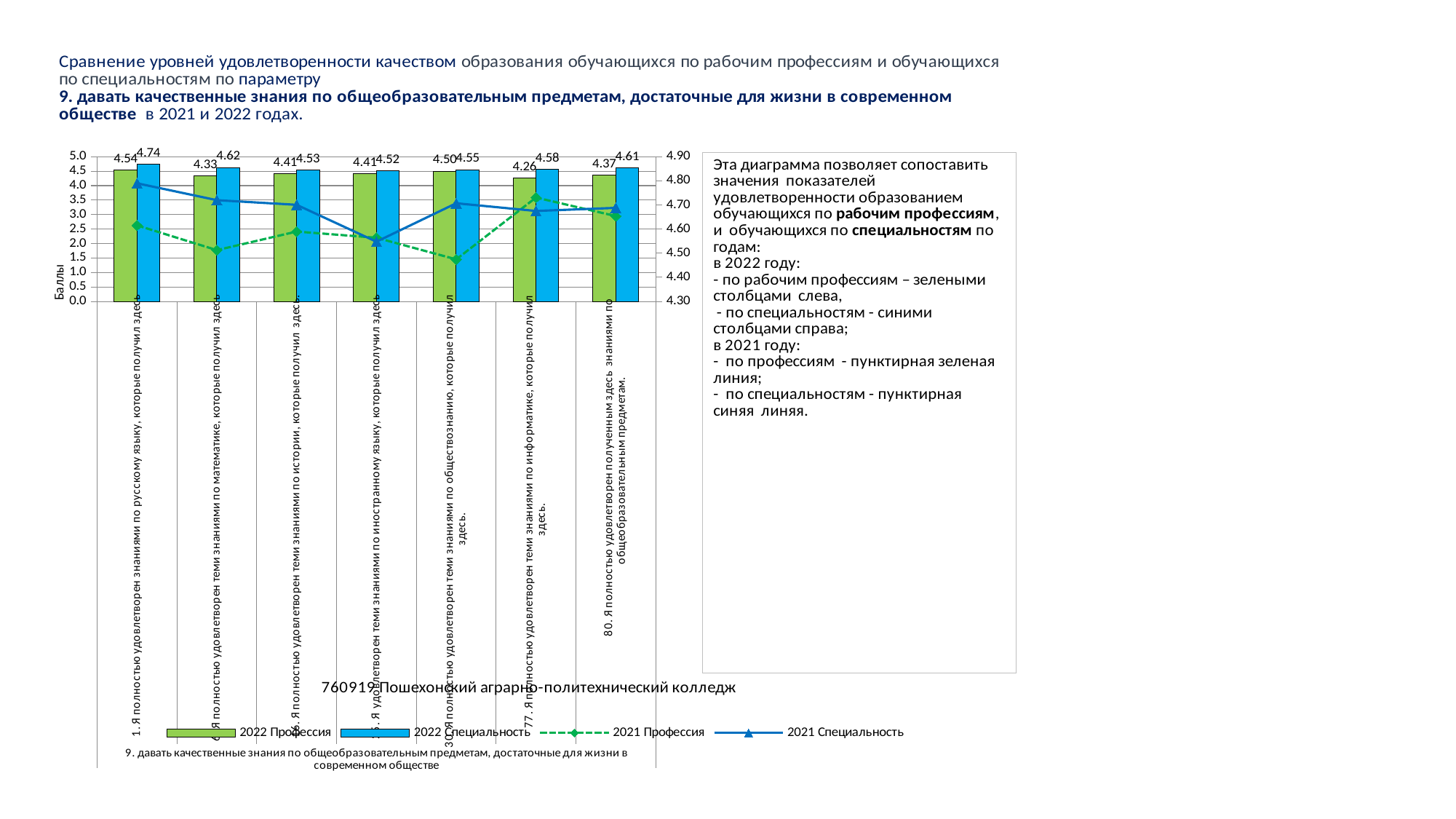
Which category has the highest 2022 Специальность bar? 1. Я полностью удовлетворен знаниями по русскому языку (4.74) How many series does the chart legend list? 4 How many categories are shown on the x axis of the chart? 7 What is the value of the 2022 Профессия bar for the category about русский язык (1. Я полностью удовлетворен знаниями по русскому языку)? 4.54 Which category has the lowest 2022 Профессия bar? 77. Я полностью удовлетворен теми знаниями по информатике (4.26) What is the value of the 2022 Специальность bar for the category about математика? 4.62 What is the value of the 2022 Профессия bar for the category about информатика? 4.26 For the category about обществознание, which is larger: the 2022 Профессия bar or the 2022 Специальность bar? 2022 Специальность (4.55) On the right-hand axis, is the 2021 Профессия line value for the category about математика greater or less than 4.60? less What is the value of the 2022 Специальность bar for the last category (80. Я полностью удовлетворен полученным здесь знаниями по общеобразовательным предметам)? 4.61 Which series is drawn as green bars in the chart? 2022 Профессия What is the difference between the 2022 Специальность and 2022 Профессия values for the category about информатика? 0.32